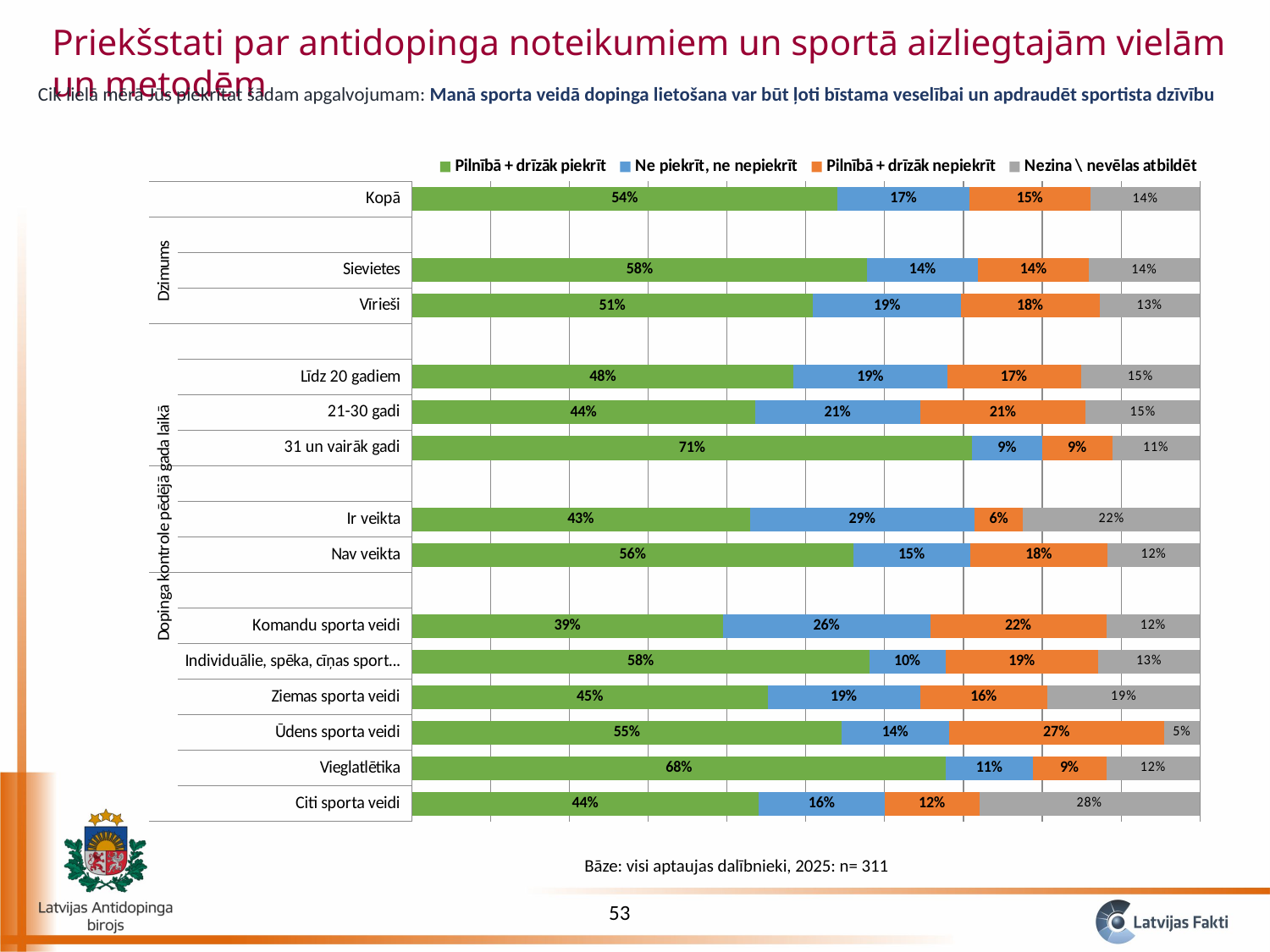
Which category has the highest value for "Pilnībā + drīzāk piekrīt"? 31 un vairāk gadi What is the difference between the "Pilnībā + drīzāk piekrīt" values for Sievietes and Vīrieši? 7% What is the value of "Nezina \ nevēlas atbildēt" for Citi sporta veidi? 28% What kind of chart is shown on the slide? stacked bar chart Which category has the lowest value for "Pilnībā + drīzāk piekrīt"? Komandu sporta veidi What is the total of the stacked bar for Ir veikta? 100% What is the value of "Pilnībā + drīzāk nepiekrīt" for Ūdens sporta veidi? 27% How many categories (bars) are plotted in the chart? 14 What is the value of "Pilnībā + drīzāk piekrīt" for Kopā? 54% Which has a larger "Ne piekrīt, ne nepiekrīt" value, Komandu sporta veidi or Vieglatlētika? Komandu sporta veidi What is the value of "Ne piekrīt, ne nepiekrīt" for Ir veikta? 29% How many series does the legend list? 4